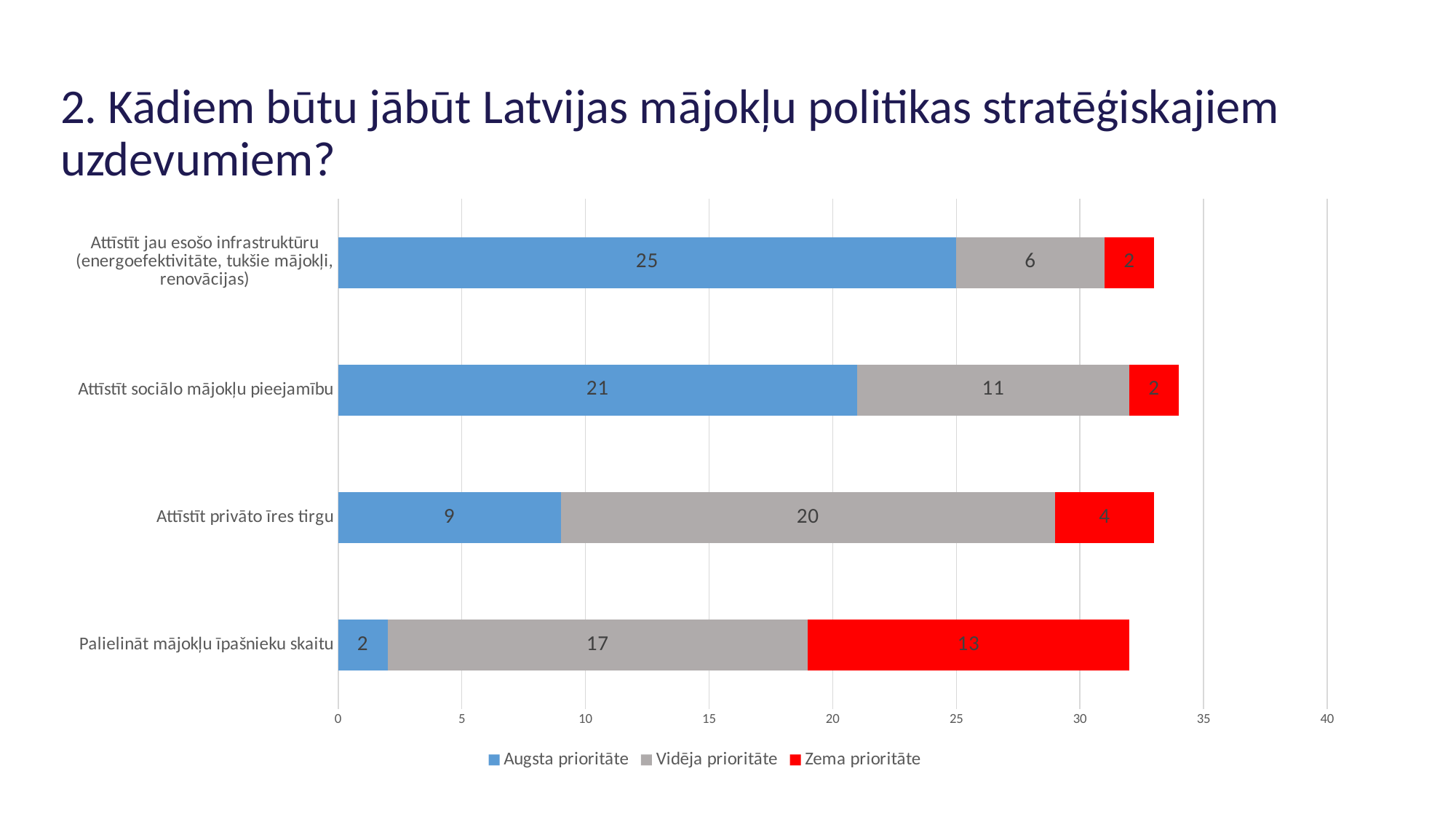
How many categories are shown on the chart? 4 What is the 'Zema prioritāte' value for 'Palielināt mājokļu īpašnieku skaitu'? 13 Which category has the highest 'Augsta prioritāte' value? Attīstīt jau esošo infrastruktūru (energoefektivitāte, tukšie mājokļi, renovācijas) How many series does the legend list? 3 What kind of chart is shown on the slide? Stacked bar chart Which is larger: the 'Vidēja prioritāte' value for 'Attīstīt sociālo mājokļu pieejamību' or for 'Palielināt mājokļu īpašnieku skaitu'? Palielināt mājokļu īpašnieku skaitu What is the 'Augsta prioritāte' value for 'Attīstīt sociālo mājokļu pieejamību'? 21 What is the difference between the 'Augsta prioritāte' values for 'Attīstīt jau esošo infrastruktūru' and 'Attīstīt privāto īres tirgu'? 16 What is the 'Vidēja prioritāte' value for 'Attīstīt privāto īres tirgu'? 20 Which category has the lowest 'Augsta prioritāte' value? Palielināt mājokļu īpašnieku skaitu What is the total of the stacked bar for 'Attīstīt sociālo mājokļu pieejamību'? 34 What is the total of the stacked bar for 'Palielināt mājokļu īpašnieku skaitu'? 32